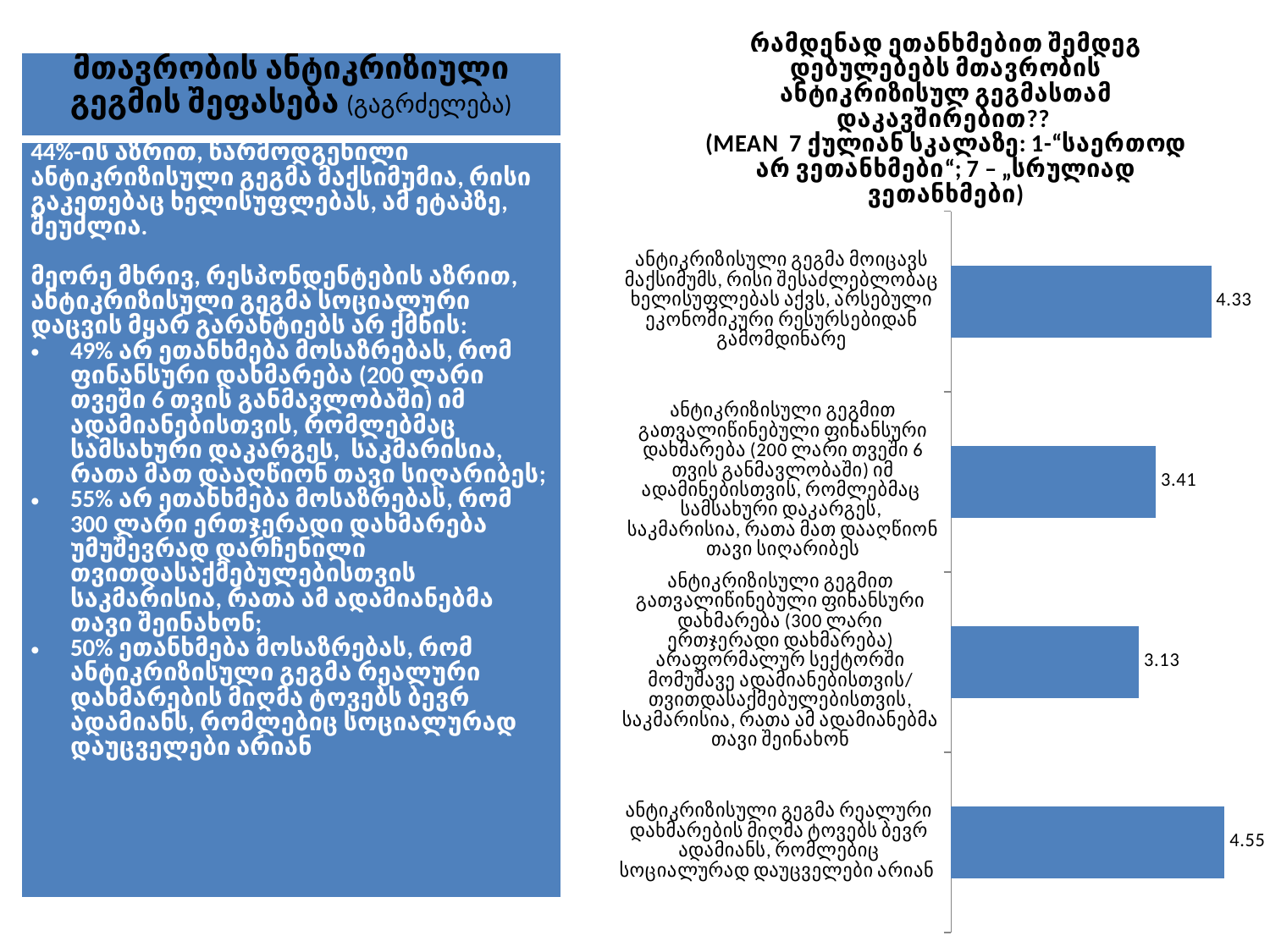
Which bar in the chart has the highest value? the bottom bar (the plan leaves many socially vulnerable people without real help), 4.55 What type of chart is shown on the right side of the slide? bar chart Which is larger: the value for the 200 GEL assistance statement or the value for the 300 GEL assistance statement? the 200 GEL assistance statement (3.41) What is the difference between the top bar (4.33) and the second bar (3.41)? 0.92 What is the difference between the highest value (4.55) and the lowest value (3.13) in the chart? 1.42 What is the value of the bottom bar in the chart (the statement that the plan leaves many socially vulnerable people without real help)? 4.55 What is the value of the bar for the statement about the 200 GEL monthly assistance for 6 months (second bar from the top)? 3.41 Which bar in the chart has the lowest value? the third bar (one-time 300 GEL assistance), 3.13 How many bars (categories) does the chart on the right show? 4 What is the value of the top bar in the chart (the statement that the anti-crisis plan covers the maximum the government can do)? 4.33 What is the value of the bar for the statement about the one-time 300 GEL assistance (third bar from the top)? 3.13 According to the chart title, what scale was used for the mean values? a 7-point scale (1 – strongly disagree; 7 – fully agree)